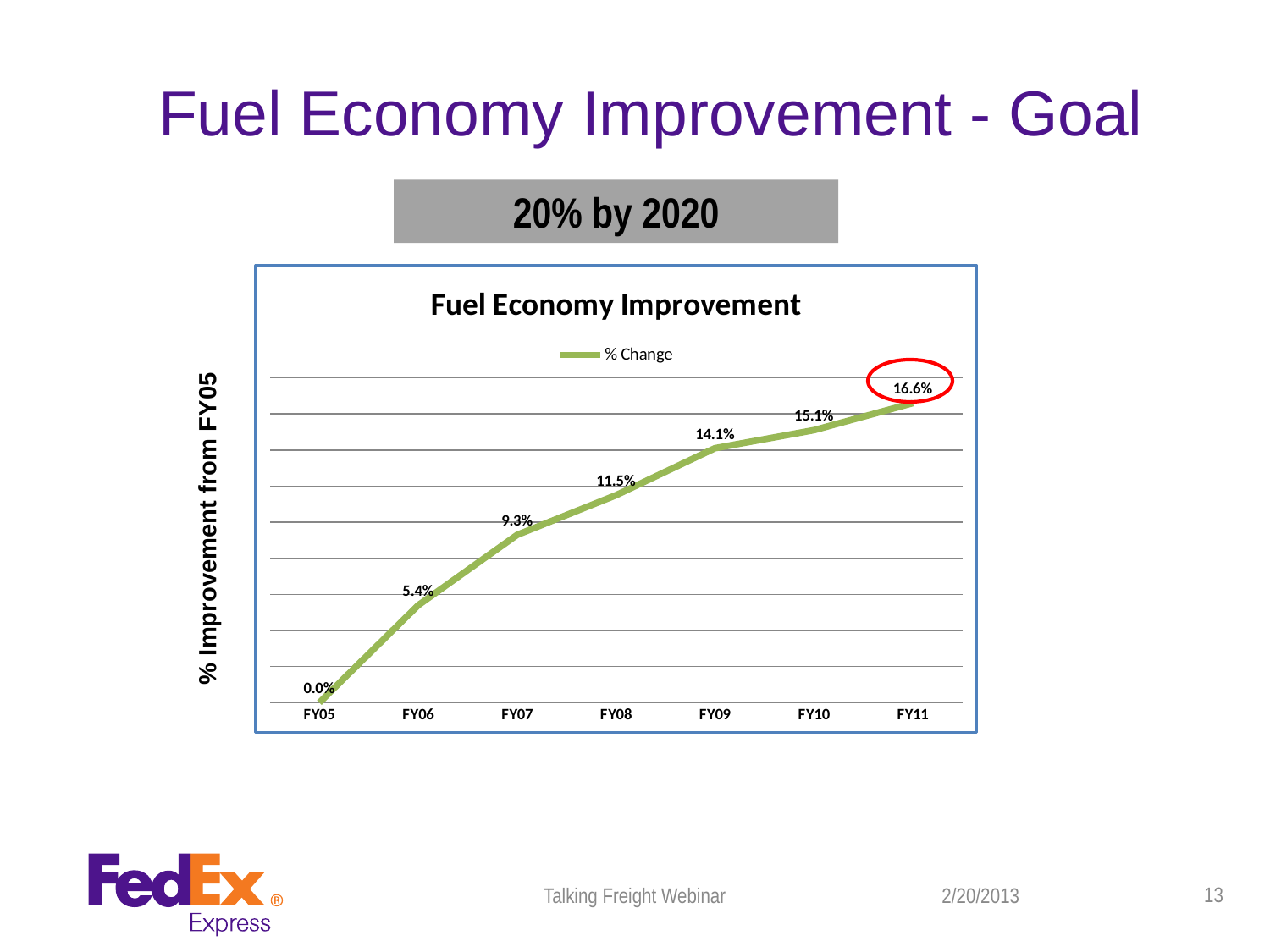
Which fiscal year has the lowest % Change value? FY05 Which is larger, the % Change value for FY07 or for FY08? FY08 What is the difference between the % Change values for FY09 and FY07? 4.8% What is the difference between the % Change values for FY11 and FY10? 1.5% Do the % Change values rise or fall from FY05 to FY11? rise What is the % Change value for FY06? 5.4% What is the % Change value for FY08? 11.5% How many series does the legend list? 1 Which fiscal year has the highest % Change value? FY11 How many fiscal years are plotted on the x axis? 7 What is the % Change value for FY11? 16.6% What kind of chart is shown? line chart